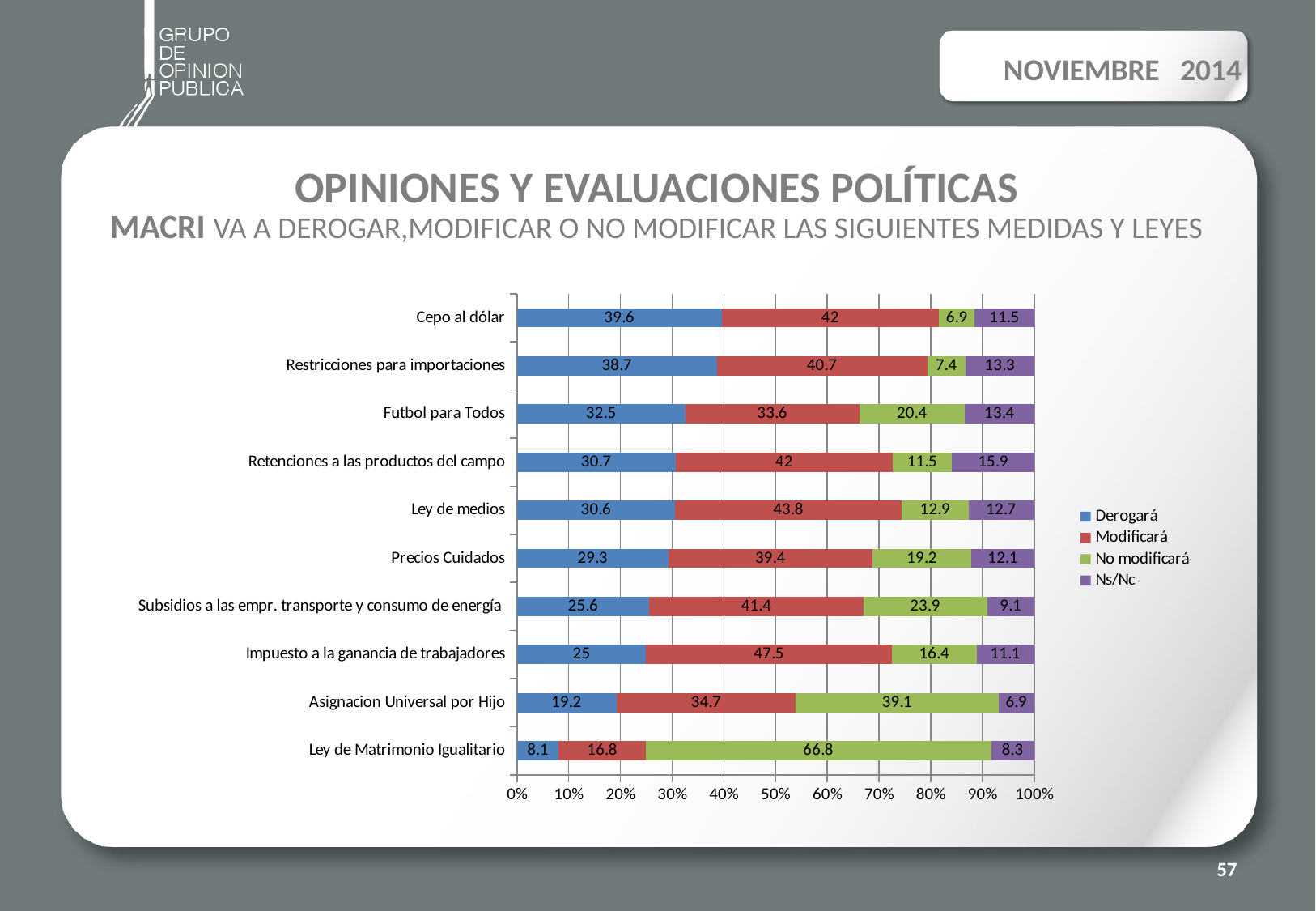
What is the No modificará value for Ley de Matrimonio Igualitario? 66.8 What is the Ns/Nc value for Retenciones a las productos del campo? 15.9 What is the Modificará value for Impuesto a la ganancia de trabajadores? 47.5 What is the Derogará value for Cepo al dólar? 39.6 What kind of chart is shown on the slide? Stacked bar chart How many series does the legend list? 4 What is the difference between the No modificará and Derogará values for Ley de Matrimonio Igualitario? 58.7 Which has a larger Derogará value, Futbol para Todos or Precios Cuidados? Futbol para Todos Which category has the highest Derogará value? Cepo al dólar How many categories (measures and laws) are shown in the chart? 10 Which category has the lowest Ns/Nc value? Asignacion Universal por Hijo Which colour represents the Modificará series in the chart? Red